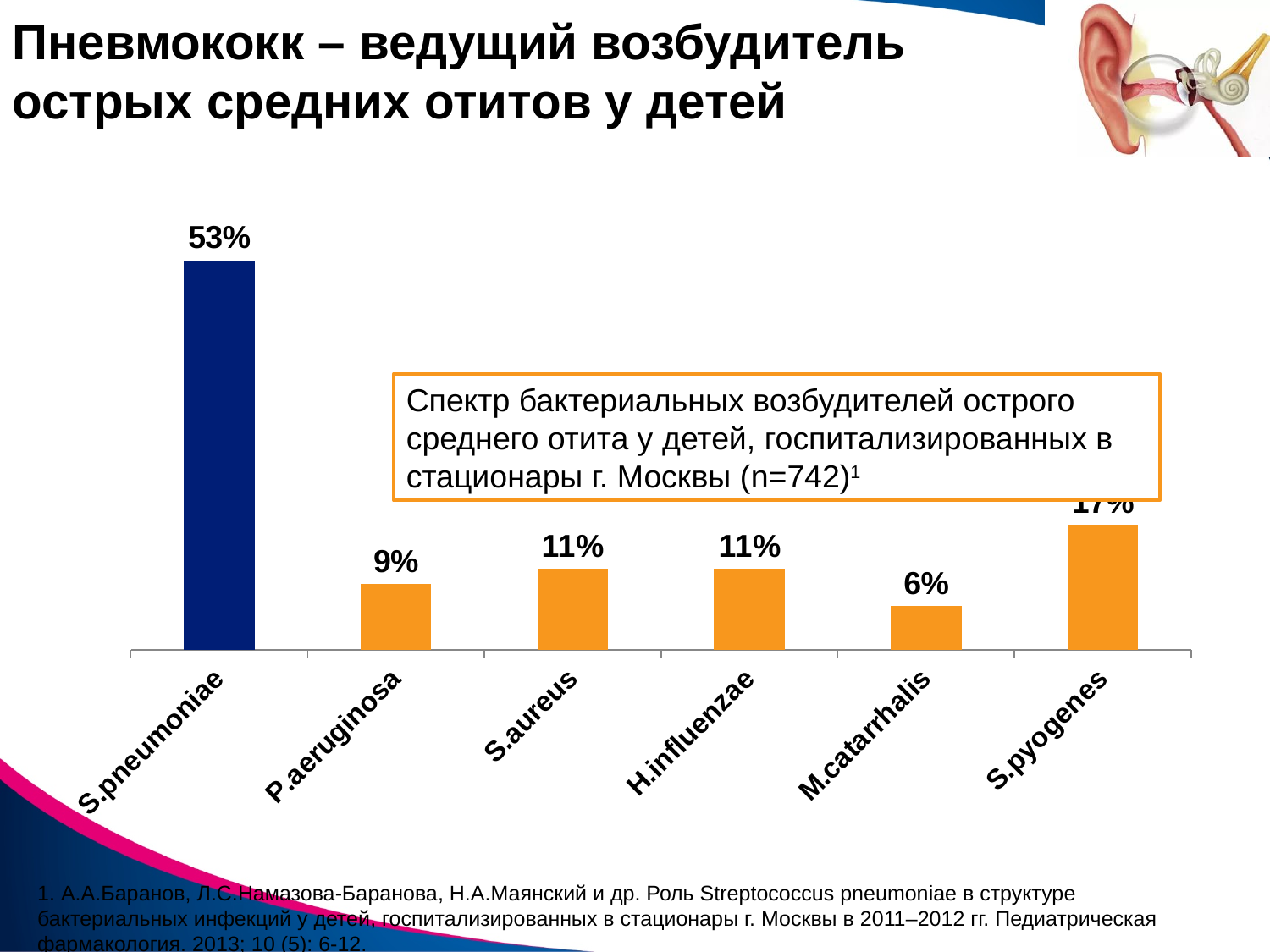
What is the value for M.catarrhalis? 6% Which bar is coloured differently from the others? S.pneumoniae What is the value for P.aeruginosa? 9% What is the value for S.pneumoniae? 53% What is the value for H.influenzae? 11% What is the difference between the values for P.aeruginosa and M.catarrhalis? 3% How many categories are shown on the x axis? 6 What kind of chart is shown on the slide? Bar chart Which category has the lowest value? M.catarrhalis What is the difference between the values for S.pneumoniae and S.aureus? 42% Which category has the highest value? S.pneumoniae Which is larger, the value for S.pyogenes or the value for S.aureus? S.pyogenes